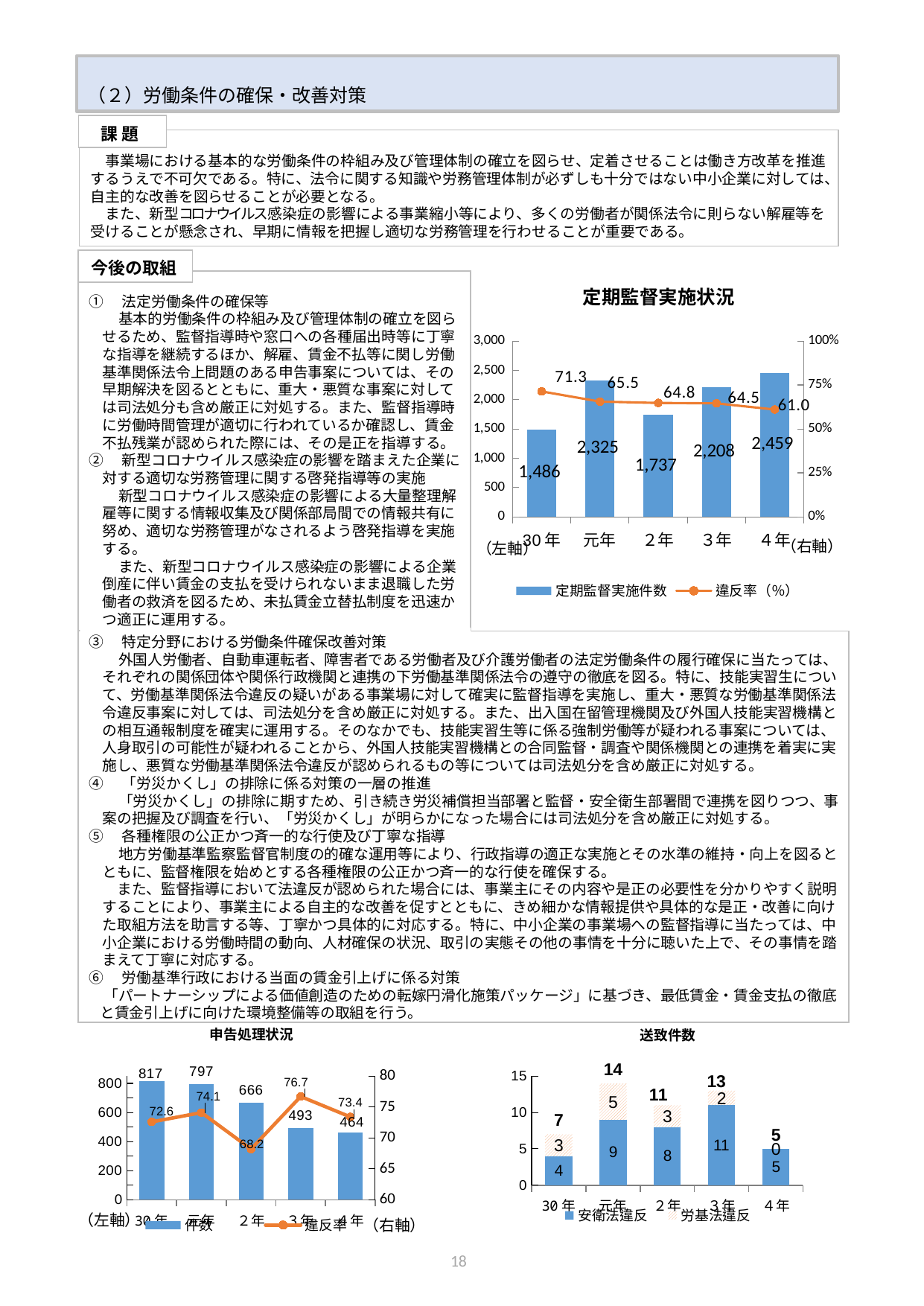
In the 申告処理状況 chart, which year has the highest 違反率? 3年 In the 定期監督実施状況 chart, what is the 違反率 (%) for 30年? 71.3 In the 申告処理状況 chart, what is the difference in 件数 between 30年 and 4年? 353 In the 定期監督実施状況 chart, what is the difference in 定期監督実施件数 between 元年 and 2年? 588 In the 送致件数 chart, which year has the lowest total? 4年 In the 送致件数 chart, what is the 安衛法違反 value for 3年? 11 In the 定期監督実施状況 chart, what is the value of 定期監督実施件数 for 4年? 2,459 In the 定期監督実施状況 chart, which year has the lowest 定期監督実施件数? 30年 In the 申告処理状況 chart, how many series does the legend list? 2 In the 申告処理状況 chart, what is the 件数 for 2年? 666 In the 送致件数 chart, what is the total for 元年? 14 In the 定期監督実施状況 chart, does the 違反率 (%) rise or fall from 30年 to 4年? fall